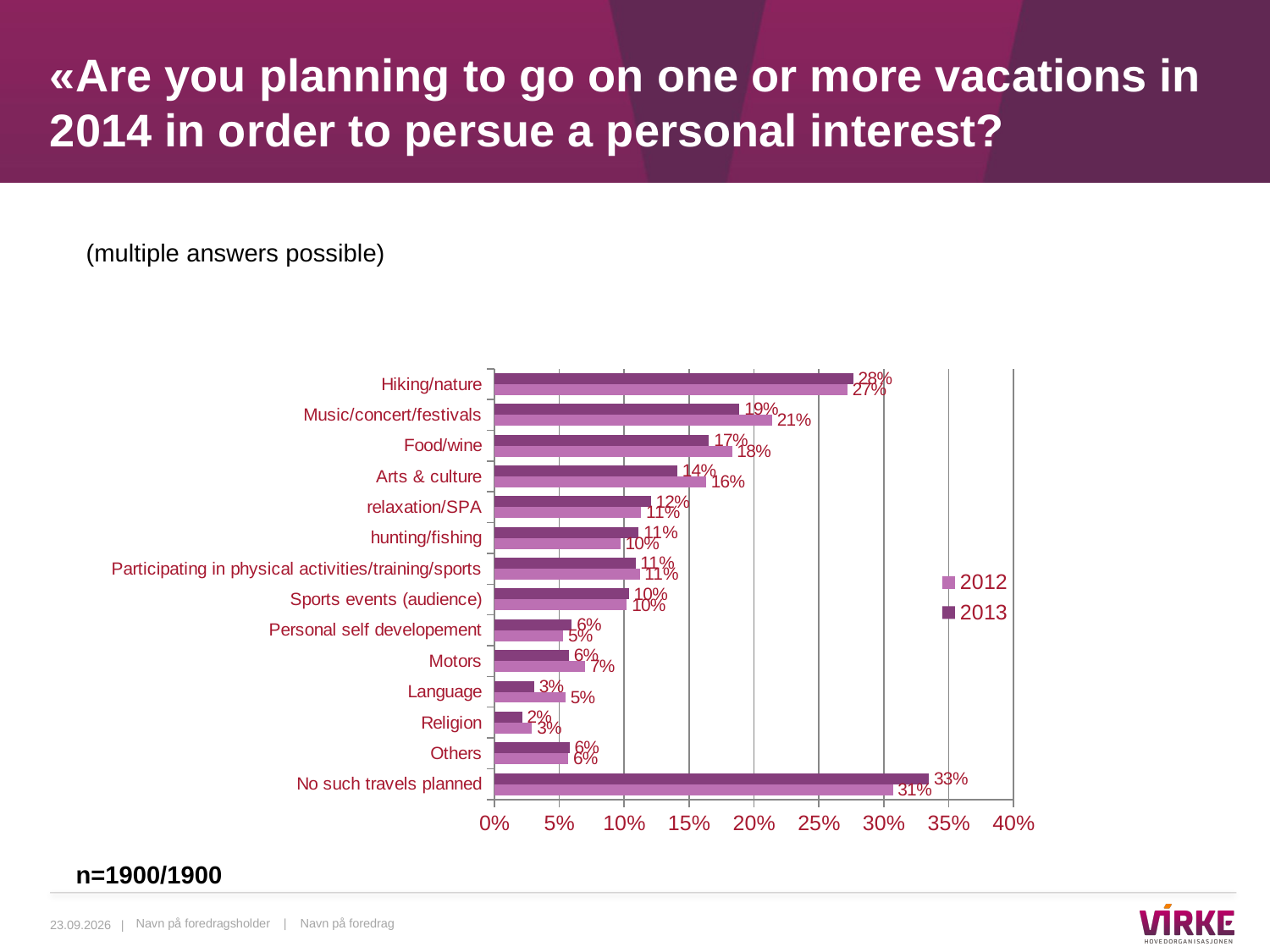
Which series is shown in the darker purple colour in the legend? 2013 What is the 2013 value for Language? 3% Which category has the highest 2013 value? No such travels planned What is the difference between the 2012 and 2013 values for Language? 2% How many series does the legend list? 2 What is the difference between the 2013 and 2012 values for No such travels planned? 2% What kind of chart is shown on the slide? bar chart What is the 2013 value for Hiking/nature? 28% Which is larger for Arts & culture, the 2012 value or the 2013 value? 2012 What is the 2012 value for Music/concert/festivals? 21% How many categories are shown on the chart? 14 Which category has the lowest 2013 value? Religion